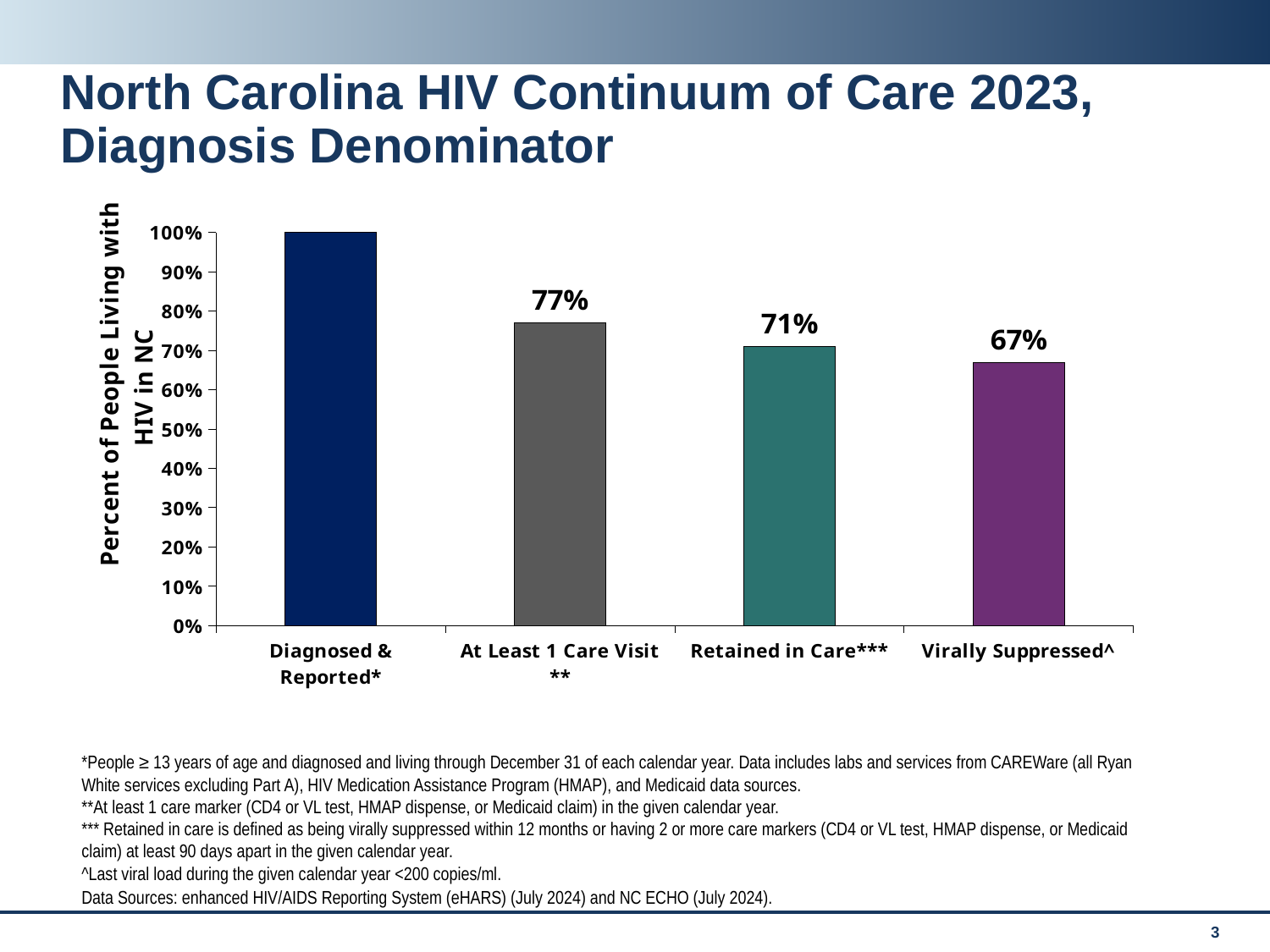
What is the value for At Least 1 Care Visit**? 77% What kind of chart is shown on the slide? Bar chart What is the difference between the values for At Least 1 Care Visit** and Virally Suppressed^? 10% Which category has the lowest value? Virally Suppressed^ What is the value for Diagnosed & Reported*? 100% What is the difference between the values for Retained in Care*** and Virally Suppressed^? 4% Do the values rise or fall from left to right along the x axis? Fall What is the value for Retained in Care***? 71% How many categories are shown on the x axis? 4 Which category has the highest value? Diagnosed & Reported* Which is larger, the value for At Least 1 Care Visit** or the value for Retained in Care***? At Least 1 Care Visit** What is the value for Virally Suppressed^? 67%